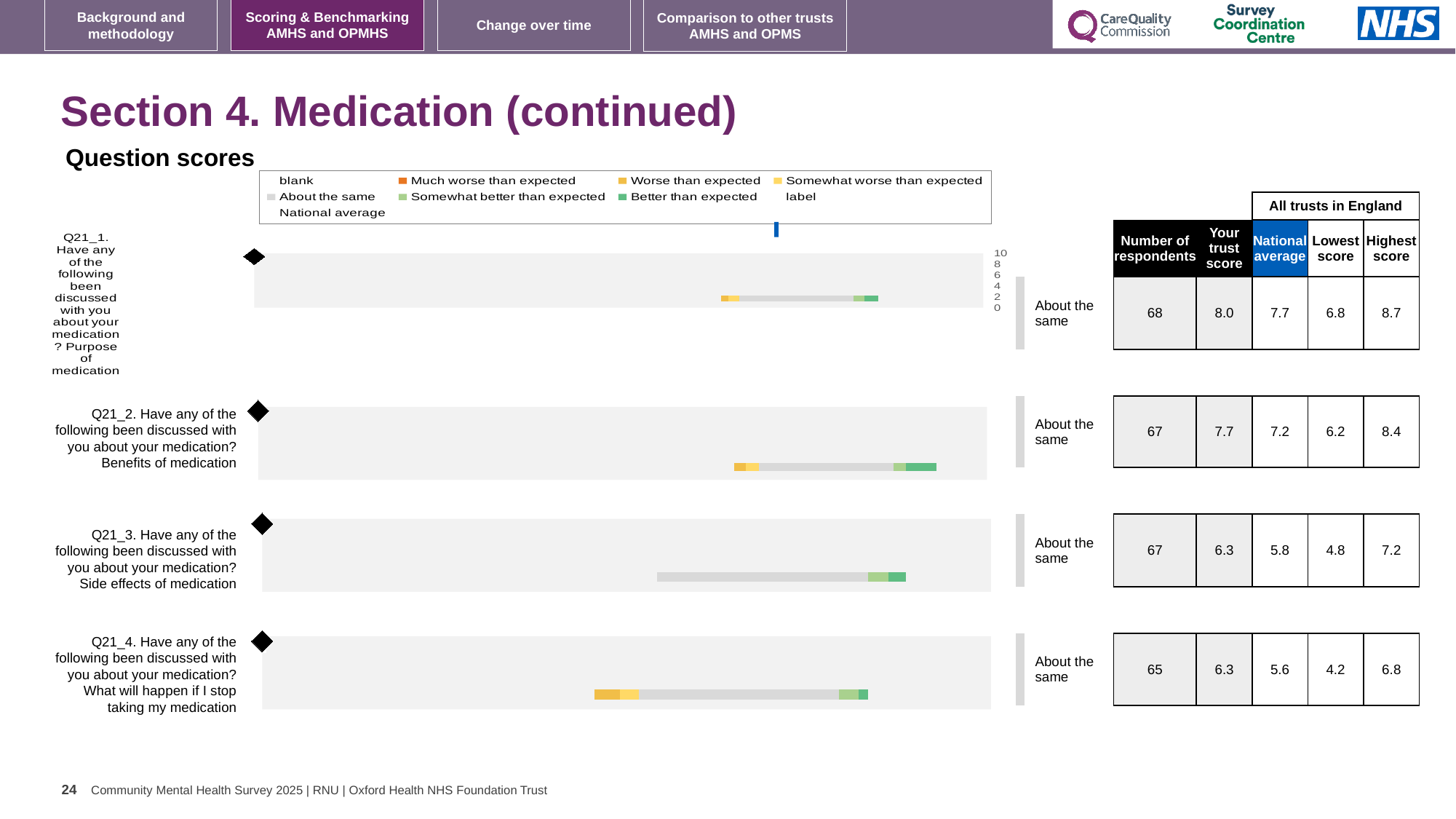
For the Q21_1 chart, what is the difference between 'Your trust score' and the National average? 0.3 For the Q21_3 chart (Side effects of medication), what is the Lowest score among all trusts in England? 4.8 For the Q21_1 chart (Purpose of medication), what is 'Your trust score'? 8.0 Which question chart has the highest 'Your trust score'? Q21_1 (Purpose of medication) In the chart legend, what colour represents 'Much worse than expected'? orange For the Q21_2 chart (Benefits of medication), what is the National average? 7.2 What kind of chart is used to show the question scores on this slide? bar chart How many question score charts (Q21_1 to Q21_4) are shown on the slide? 4 For the Q21_4 chart (What will happen if I stop taking my medication), how many respondents are there? 65 Which question chart has the lowest number of respondents? Q21_4 (What will happen if I stop taking my medication) In the chart legend, what colour represents 'Better than expected'? green For the Q21_2 chart, which is larger: 'Your trust score' or the National average? Your trust score